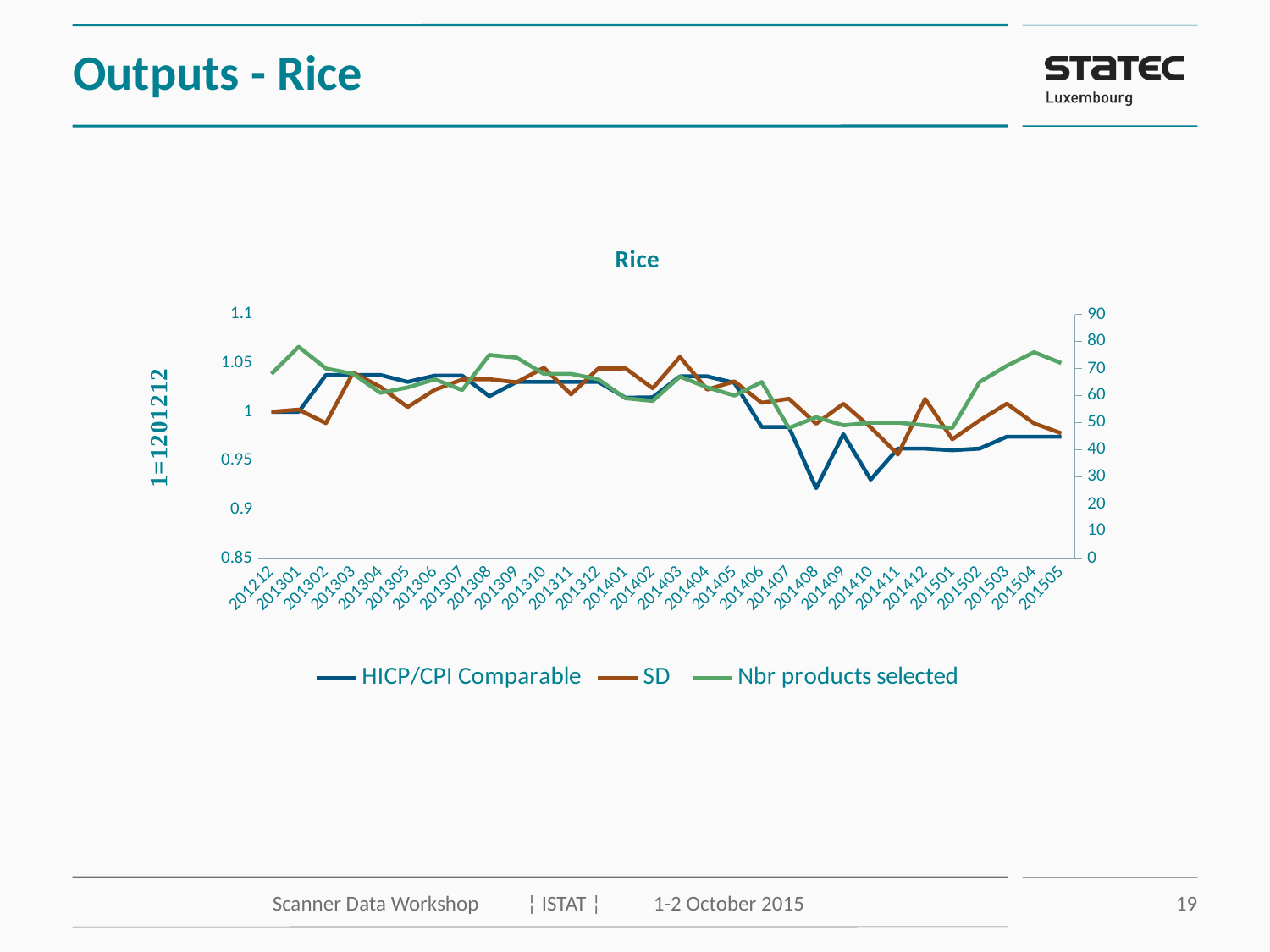
What is the title of the chart? Rice Does the HICP/CPI Comparable series rise or fall between 201405 and 201408? fall How many time points are plotted along the x axis of the Rice chart? 30 What is the label on the left vertical axis of the chart? 1=201212 Is the value of HICP/CPI Comparable at 201408 greater or less than 0.95? less Is the value of Nbr products selected at 201410 greater or less than 60? less At 201408, which series has the larger value: HICP/CPI Comparable or SD? SD Is the value of Nbr products selected at 201504 greater or less than 70? greater How many series does the legend of the Rice chart list? 3 What kind of chart is shown on the slide? line chart At which time point does the HICP/CPI Comparable series reach its lowest value? 201408